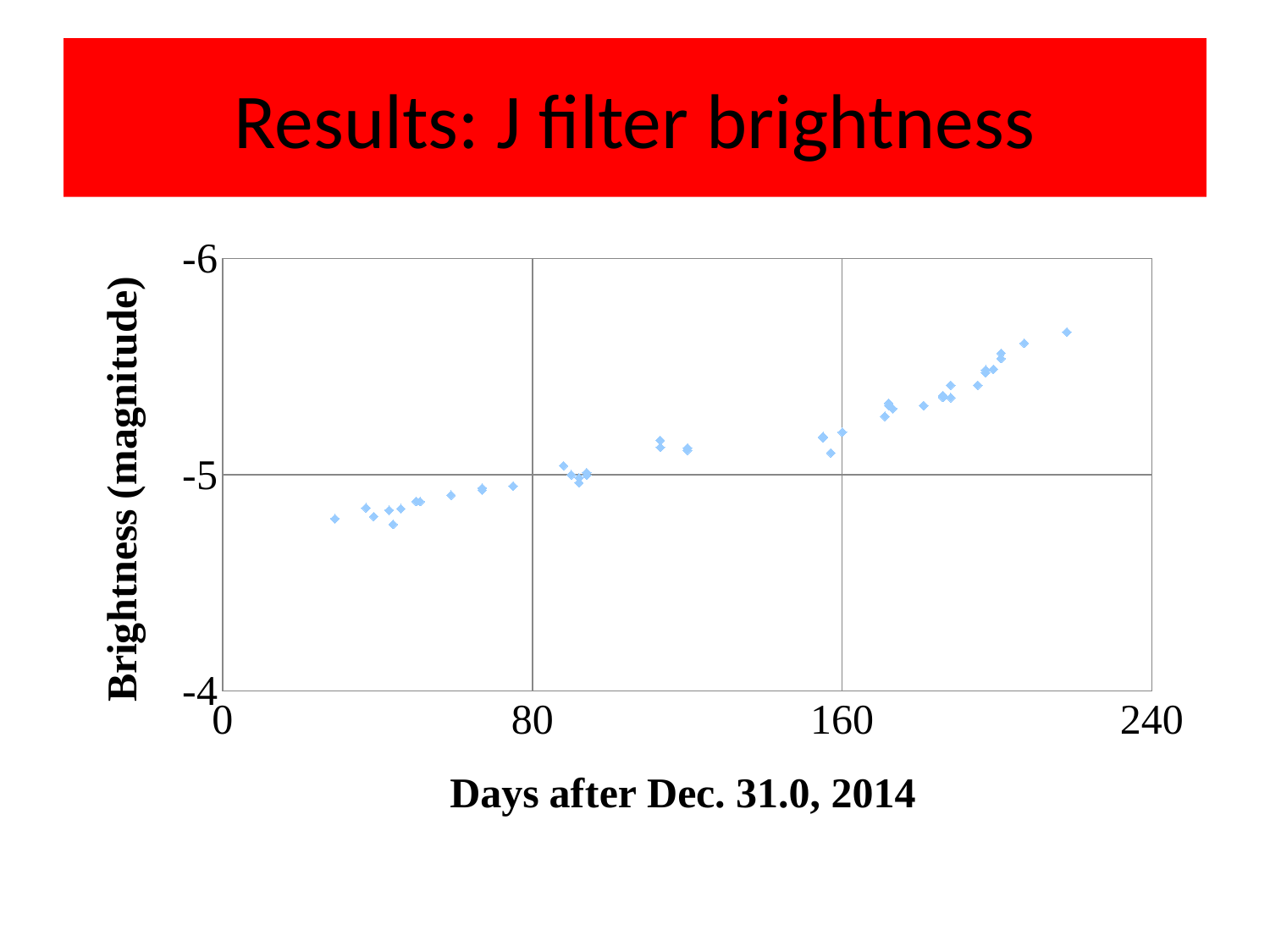
Is the brightness value for the points around day 200 numerically greater or less than -5? less Is the brightness value for the first point (around day 30) numerically greater or less than -5? greater What kind of chart is shown on the slide? scatter plot Is the brightness value for the points around day 40 numerically greater or less than -5? greater What is the title of the slide containing the chart? Results: J filter brightness What is the label of the x axis of the chart? Days after Dec. 31.0, 2014 Do the plotted points move upward or downward on the chart as the number of days increases? upward Which has the numerically lower (more negative) brightness value: the points near day 40 or the points near day 200? the points near day 200